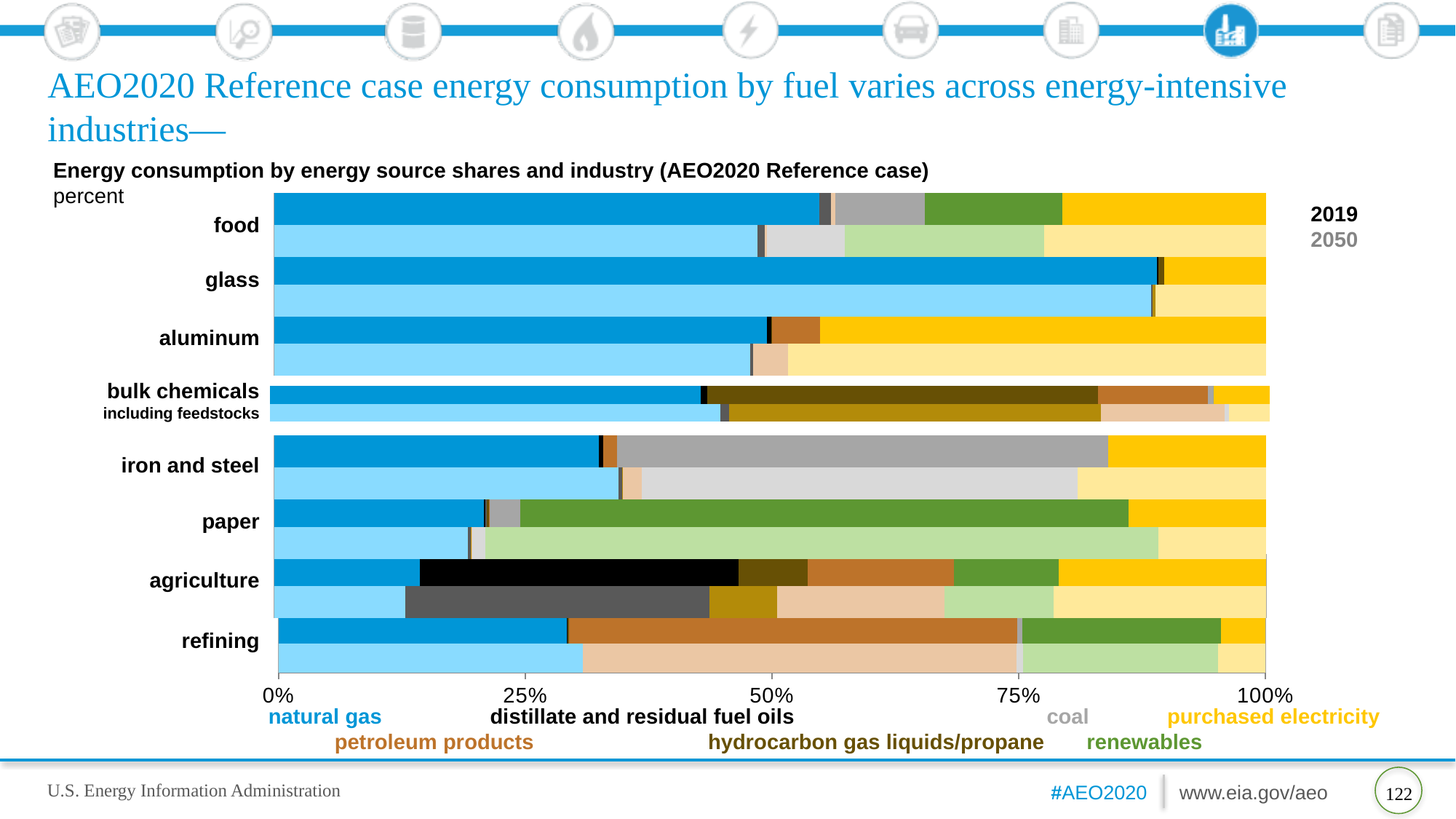
For iron and steel in 2019, which is larger: the coal share or the natural gas share? coal Which two years are compared for each industry on the chart? 2019 and 2050 How many energy sources does the legend list? 7 Is the natural gas share for paper in 2019 greater or less than 25%? less How many industries are shown on the chart? 8 For refining in 2019, which is larger: the petroleum products share or the natural gas share? petroleum products Which industry has the smallest natural gas share in 2019? agriculture Is the natural gas share for glass in 2019 greater or less than 75%? greater Which industry has the largest natural gas share in 2019? glass What is the title of the chart? Energy consumption by energy source shares and industry (AEO2020 Reference case) Is the natural gas share for refining in 2019 greater or less than 50%? less What kind of chart is shown on the slide? stacked bar chart